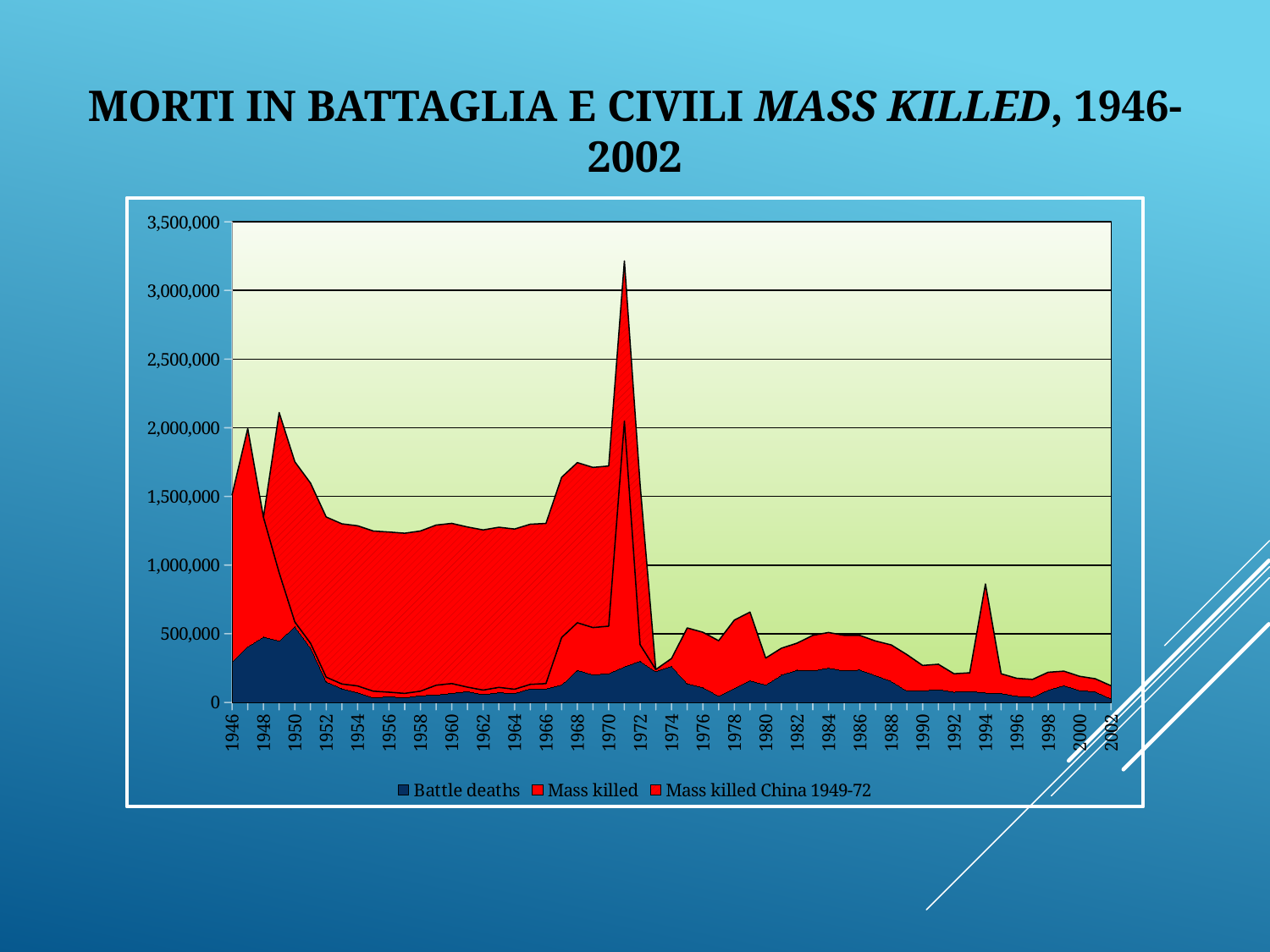
Which series is drawn in dark blue? Battle deaths Is the stacked total in 2002 greater or less than 500,000? less Which year has the larger stacked total, 1971 or 1949? 1971 What are the three series named in the legend? Battle deaths, Mass killed, Mass killed China 1949-72 In which year does the stacked total reach its highest peak? 1971 Is the stacked total in 1994 greater or less than 1,000,000? less What kind of chart is shown on the slide? area chart How many series does the legend list? 3 Do the stacked totals rise or fall between 1971 and 1973? fall Is the stacked total in 1971 greater or less than 3,000,000? greater What is the first year and the last year shown on the x axis? 1946 and 2002